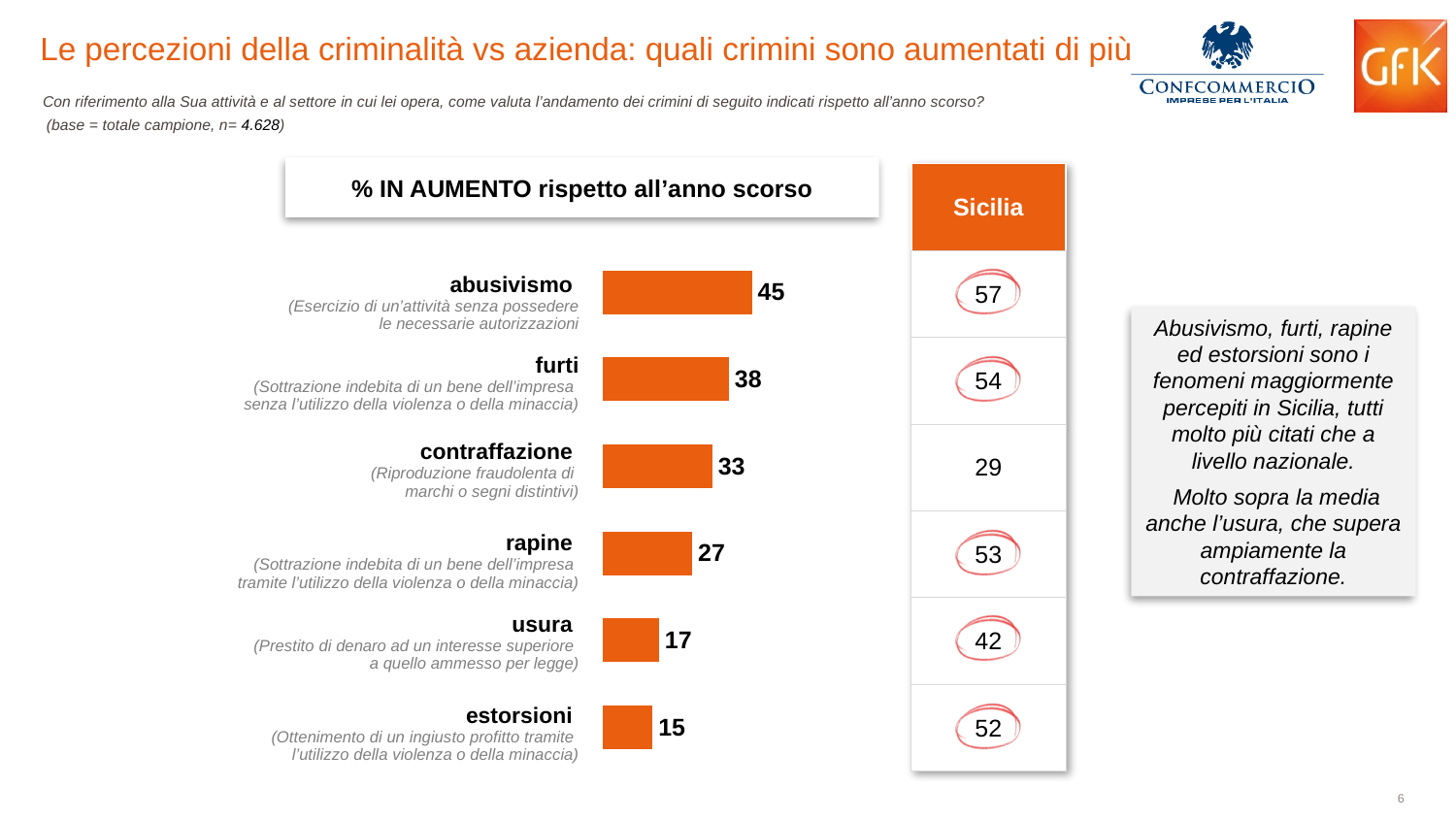
Which category has the highest value in the bar chart? abusivismo What is the difference between the values for abusivismo and furti in the bar chart? 7 What is the title of the bar chart? % IN AUMENTO rispetto all'anno scorso Which is larger in the bar chart, the value for rapine or the value for usura? rapine Which category has the lowest value in the bar chart? estorsioni What is the difference between the values for contraffazione and rapine in the bar chart? 6 What kind of chart is shown on the slide? bar chart What is the value for usura in the bar chart? 17 What is the value for abusivismo in the '% IN AUMENTO rispetto all'anno scorso' bar chart? 45 What is the value for furti in the bar chart? 38 In the Sicilia column next to the bar chart, what is the value for contraffazione? 29 How many categories are shown in the bar chart? 6